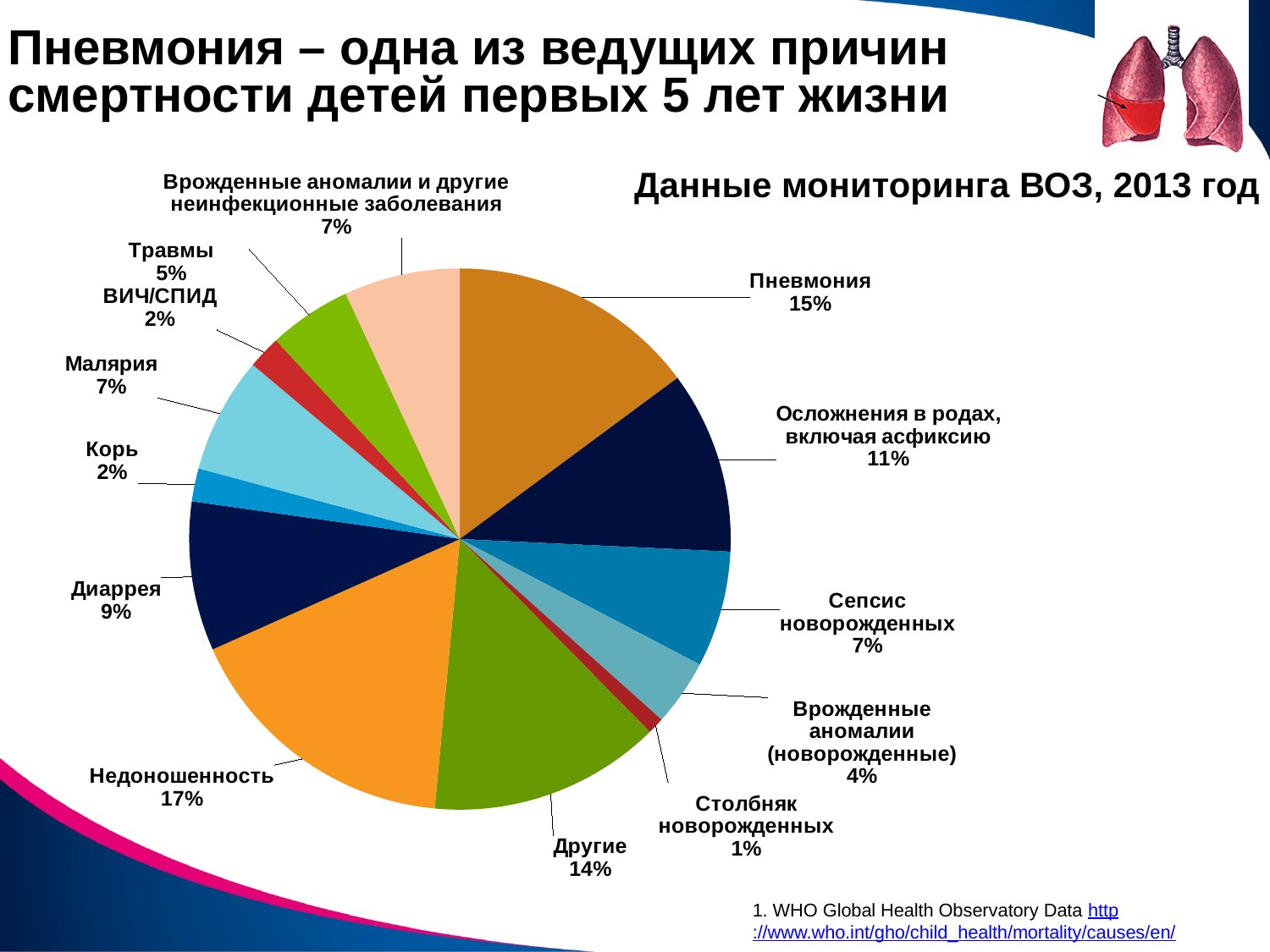
Which category has the largest share of the pie? Недоношенность What is the title text shown above the pie chart on the right? Данные мониторинга ВОЗ, 2013 год What percentage is shown for Недоношенность (prematurity)? 17% What percentage is labelled for Столбняк новорожденных (neonatal tetanus)? 1% What is the value for Диарея (diarrhoea) in the pie chart? 9% What is the difference in percentage points between Недоношенность (17%) and Пневмония (15%)? 2 What share of the pie does Пневмония (pneumonia) account for? 15% What is the combined share of Корь (2%) and ВИЧ/СПИД (2%)? 4% Which is larger: the share for Осложнения в родах, включая асфиксию or the share for Диарея? Осложнения в родах, включая асфиксию Which category has the smallest share of the pie? Столбняк новорожденных What kind of chart is shown on the slide? pie chart How many categories (slices) does the pie chart have? 13